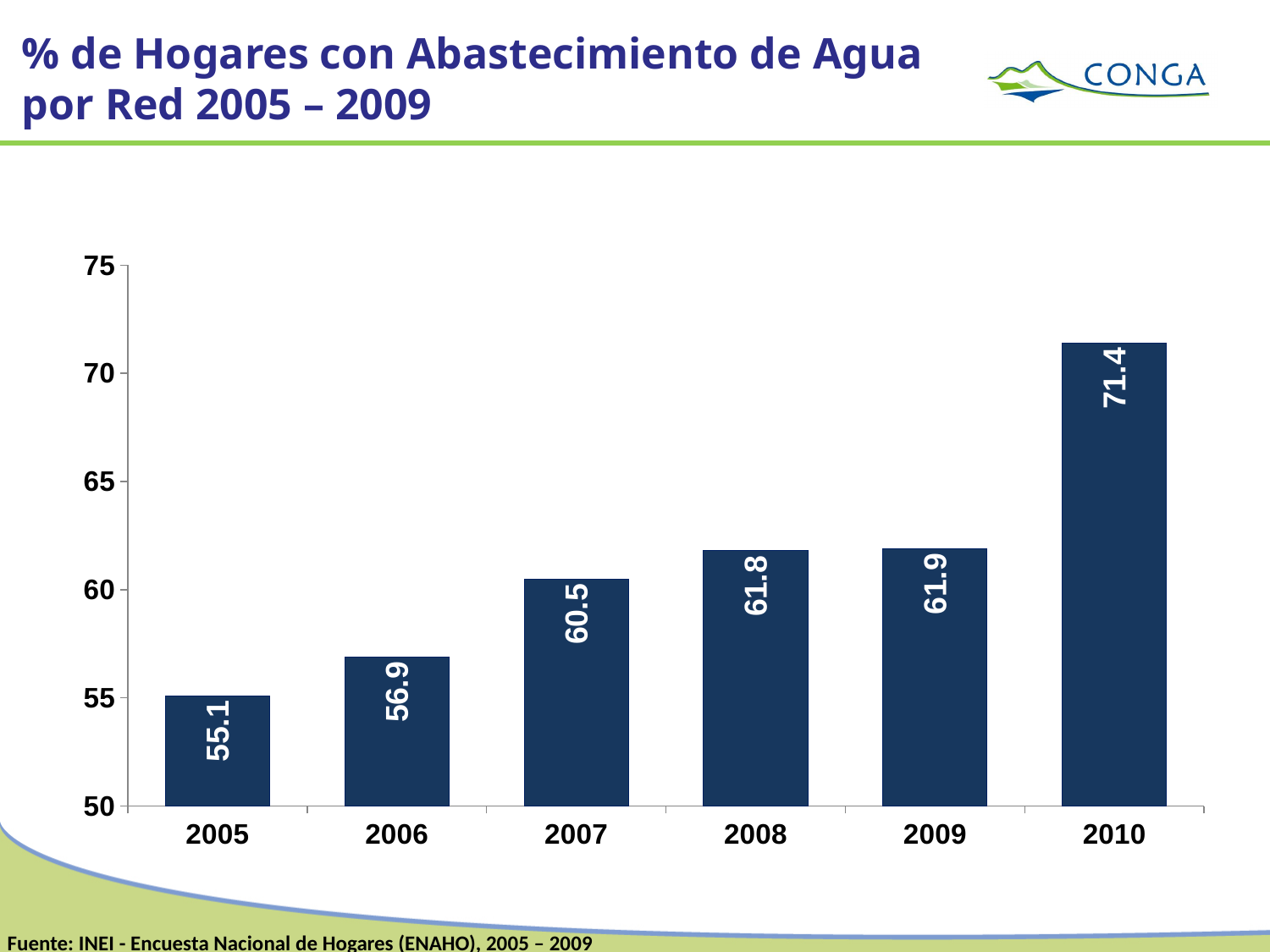
How many years are shown on the x axis? 6 What is the value for 2010? 71.4 Which year has the lowest value? 2005 Which is larger, the value for 2007 or the value for 2006? 2007 Which year has the highest value? 2010 What kind of chart is shown on the slide? bar chart What is the value for 2008? 61.8 What is the difference between the values for 2006 and 2005? 1.8 Do the values rise or fall from 2005 to 2010? rise What is the difference between the values for 2010 and 2009? 9.5 Is the value for 2010 greater or less than 70? greater What is the value for 2005? 55.1